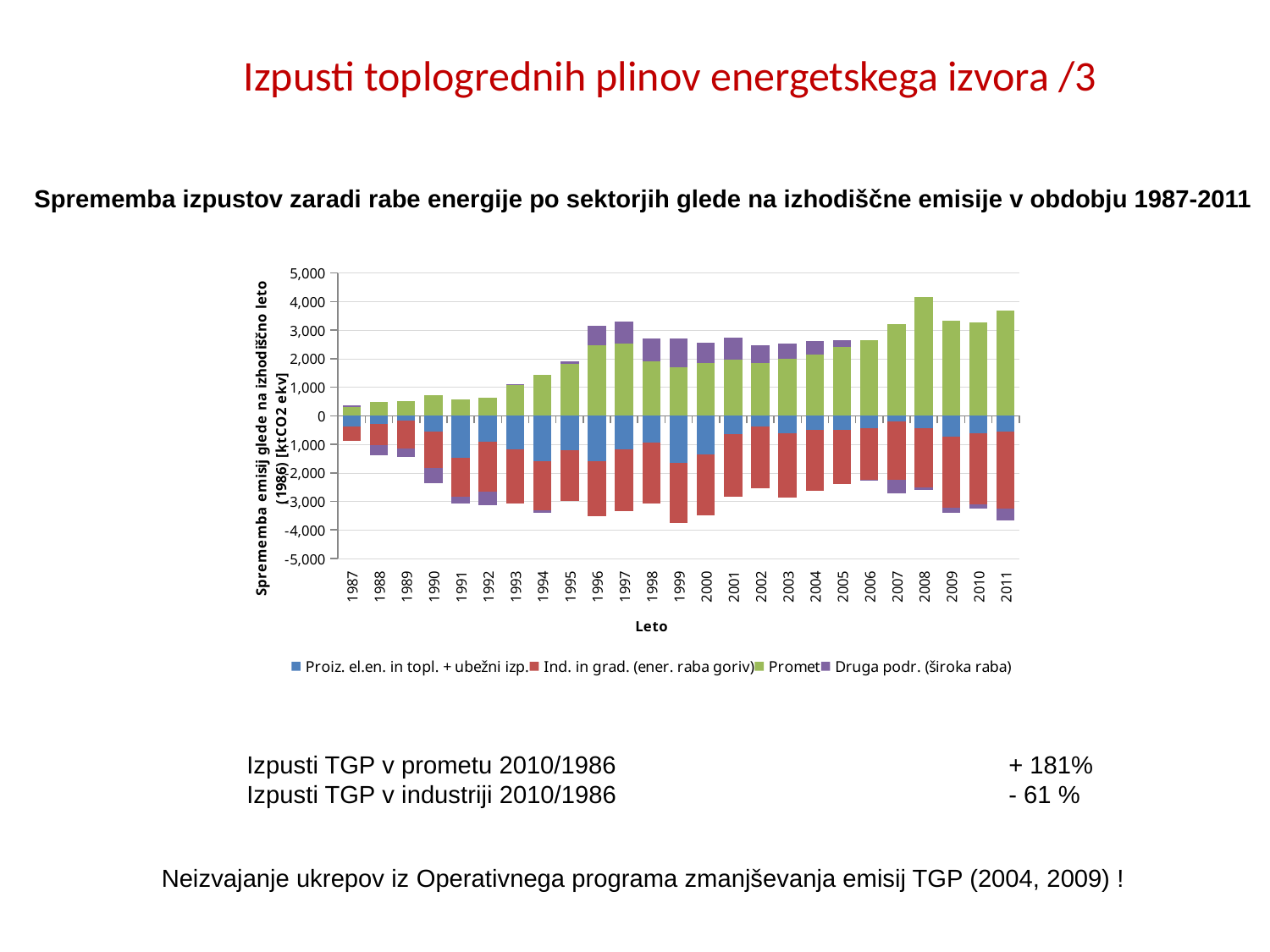
What is the first year shown on the x axis of the chart? 1987 How many series does the chart legend list? 4 Is the bottom of the negative stacked bar for 2008 greater or less than -3,000? greater Which year has the tallest positive stacked bar in the chart? 2008 Does the Promet (green) segment generally rise or fall from 1987 to 2011? rise Is the bottom of the negative stacked bar for 1999 greater or less than -3,000? less Is the positive stacked bar for 2008 taller or shorter than the positive stacked bar for 1990? taller What kind of chart is shown on the slide? stacked bar chart How many years are shown along the x axis of the chart? 25 Is the top of the positive stacked bar for 2011 greater or less than 3,000? greater What is the title of the x axis of the chart? Leto